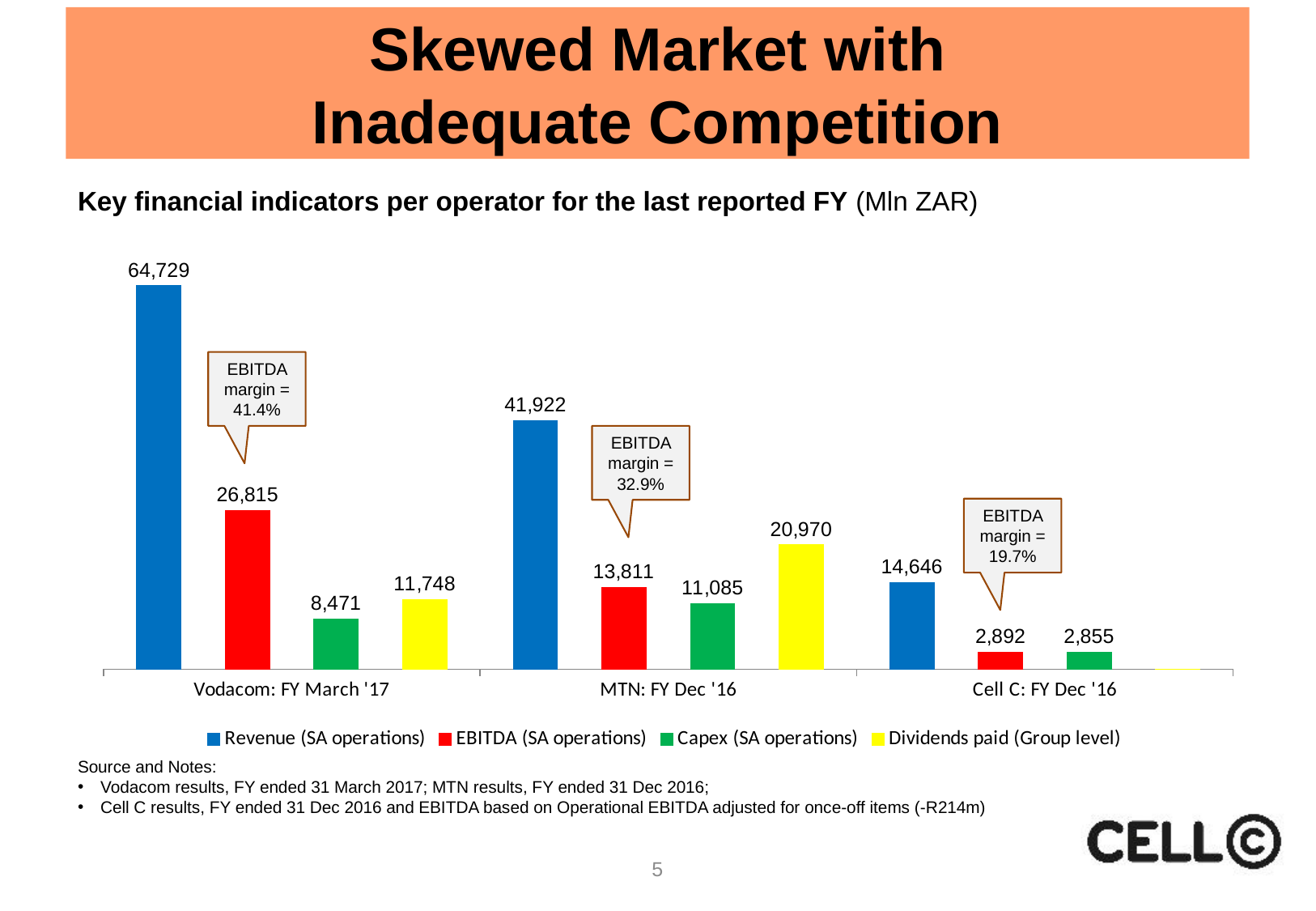
How many operators (categories) are shown on the x axis? 3 Which is larger for MTN: FY Dec '16, EBITDA (SA operations) or Dividends paid (Group level)? Dividends paid (Group level) What is the Revenue (SA operations) value for Vodacom: FY March '17? 64,729 What is the difference between MTN's and Vodacom's Dividends paid (Group level)? 9,222 What is the EBITDA (SA operations) value for MTN: FY Dec '16? 13,811 What is the Dividends paid (Group level) value for MTN: FY Dec '16? 20,970 What is the Capex (SA operations) value for Cell C: FY Dec '16? 2,855 How many series does the legend list? 4 What is the difference between Vodacom's and MTN's Revenue (SA operations)? 22,807 What EBITDA margin is shown in the callout for Cell C: FY Dec '16? 19.7% Which operator has the lowest EBITDA (SA operations)? Cell C: FY Dec '16 Which operator has the highest Revenue (SA operations)? Vodacom: FY March '17